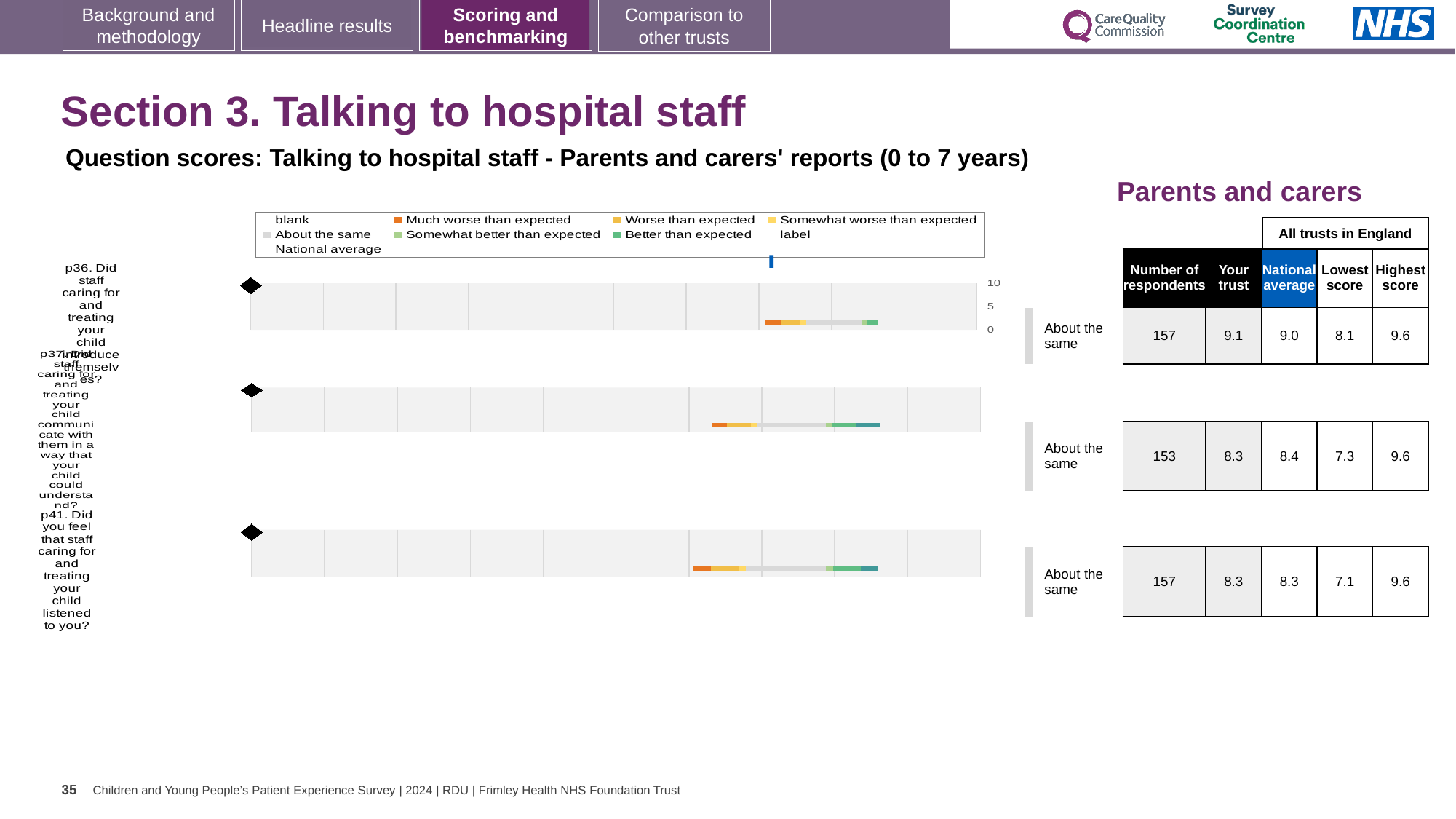
How many question charts (p36, p37, p41) are shown on the slide? 3 For the p41 chart (Did you feel that staff listened to you?), how many respondents are listed? 157 For the p37 chart, what is the Lowest score among all trusts in England? 7.3 What kind of chart is used to show the question scores on this slide? bar chart For the p37 chart, which is larger: the 'Your trust' score or the National average? National average For the p37 chart (Did staff communicate with your child in a way they could understand?), what is the National average score? 8.4 For the p36 chart, what is the Highest score among all trusts in England? 9.6 What is the highest value shown on the chart's numeric axis? 10 What benchmark category is shown next to the p41 chart? About the same For the p36 chart, what is the difference between the 'Your trust' score and the National average? 0.1 For the p36 chart (Did staff caring for and treating your child introduce themselves?), what is the 'Your trust' score in the table? 9.1 Which of the three questions (p36, p37, p41) has the highest 'Your trust' score? p36